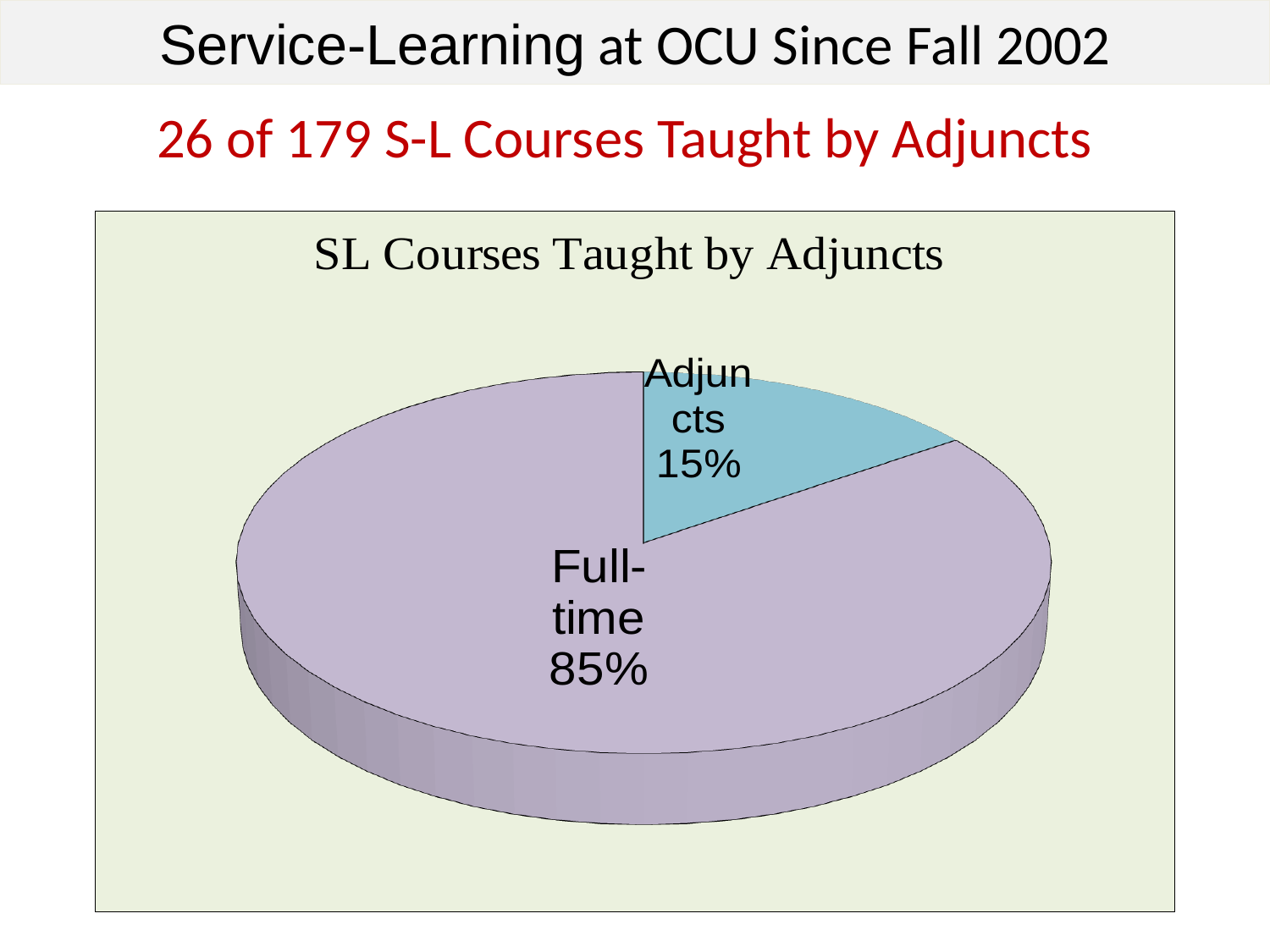
What is the title of the chart? SL Courses Taught by Adjuncts What colour is the Adjuncts slice? blue What is the difference in percentage points between the Full-time and Adjuncts slices? 70 What share of the pie is labelled Adjuncts? 15% Which slice of the pie is the smallest? Adjuncts Which is larger, the Full-time slice or the Adjuncts slice? Full-time What kind of chart is shown on the slide? pie chart Which slice of the pie is the largest? Full-time What share of the pie is labelled Full-time? 85% How many slices does the pie chart have? 2